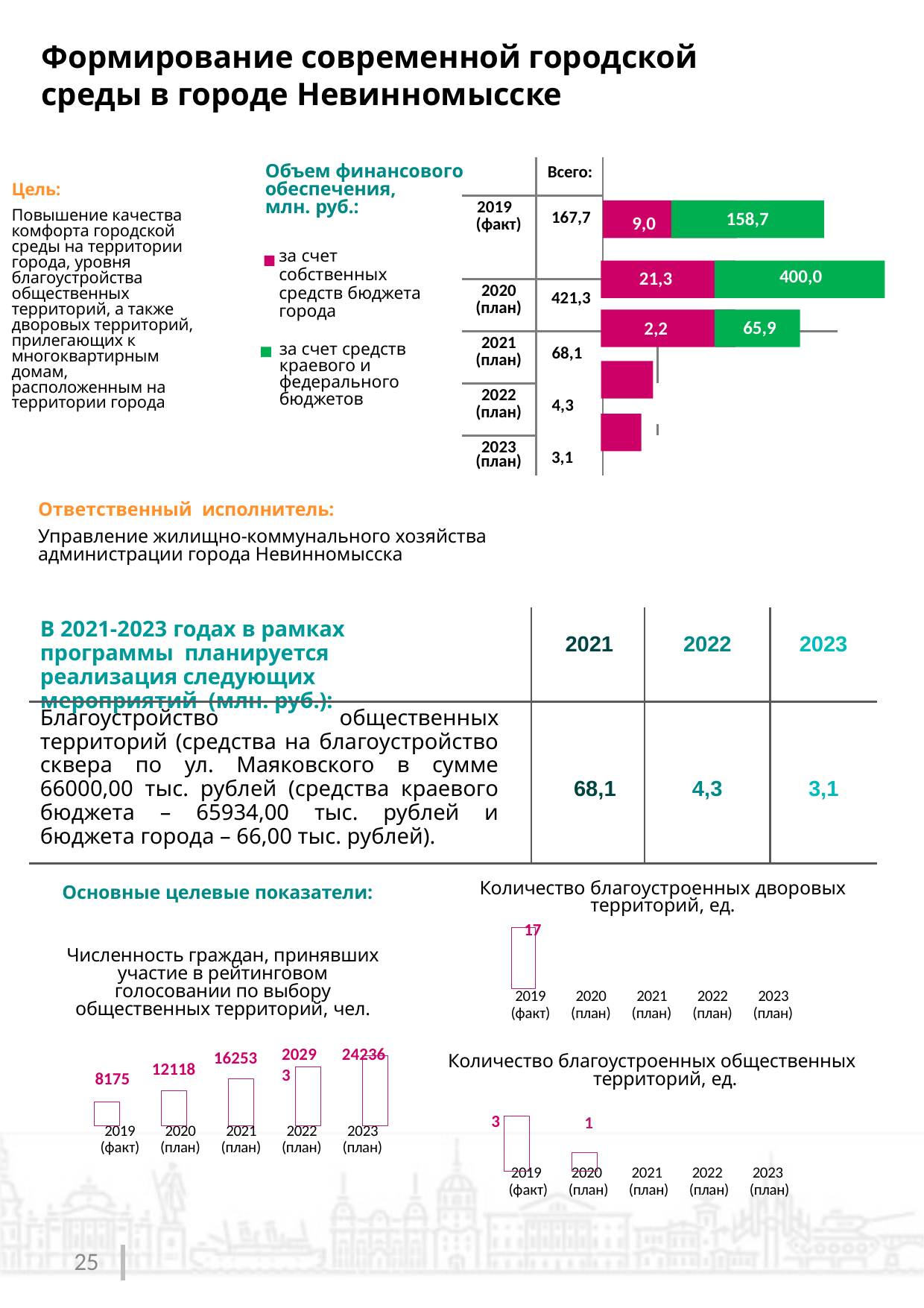
In the chart 'Количество благоустроенных дворовых территорий, ед.', what is the value for 2019 (факт)? 17 In the chart 'Объем финансового обеспечения, млн. руб.', what is the value from regional and federal budgets for 2019 (факт)? 158,7 In the chart 'Количество благоустроенных общественных территорий, ед.', which is larger: the value for 2019 (факт) or 2020 (план)? 2019 (факт) In the chart 'Объем финансового обеспечения, млн. руб.', what is the value from the city's own budget for 2021 (план)? 2,2 In the chart 'Объем финансового обеспечения, млн. руб.', how many series does the legend list? 2 In the chart 'Объем финансового обеспечения, млн. руб.', what is the difference between the regional/federal budget value and the city budget value for 2020 (план)? 378,7 In the chart 'Объем финансового обеспечения, млн. руб.', which year has the lowest total? 2023 (план) In the chart 'Численность граждан, принявших участие в рейтинговом голосовании по выбору общественных территорий, чел.', what is the value for 2021 (план)? 16253 In the chart 'Численность граждан, принявших участие в рейтинговом голосовании по выбору общественных территорий, чел.', do the values rise or fall from 2019 to 2023? Rise In the chart 'Объем финансового обеспечения, млн. руб.', what is the total (Всего) for 2020 (план)? 421,3 What kind of chart is 'Объем финансового обеспечения, млн. руб.'? Stacked bar chart In the chart 'Объем финансового обеспечения, млн. руб.', which year has the highest total? 2020 (план)